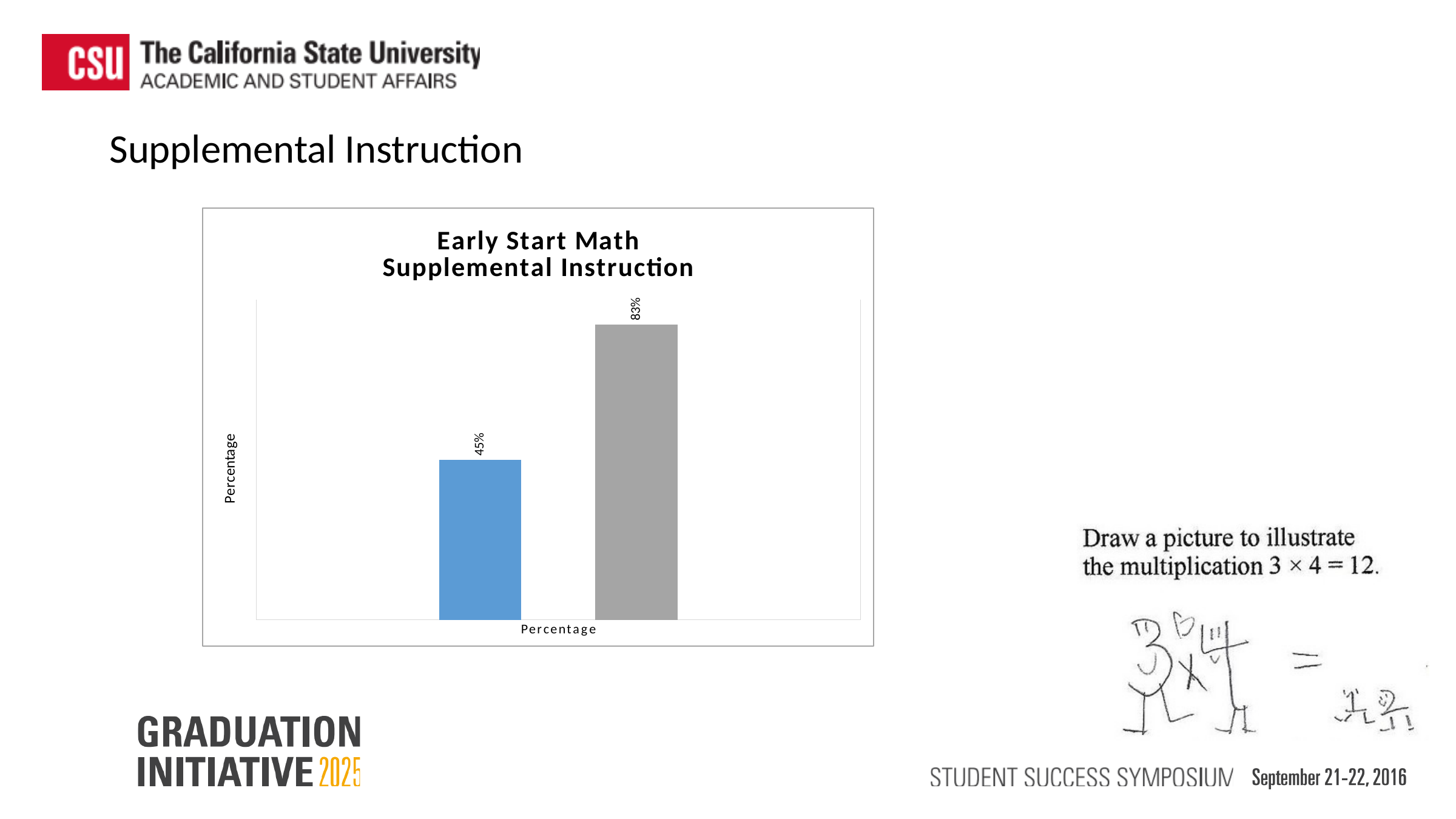
What is the label on the vertical axis of the Early Start Math Supplemental Instruction chart? Percentage Which bar is taller in the Early Start Math Supplemental Instruction chart, the blue one or the gray one? the gray one What kind of chart is the Early Start Math Supplemental Instruction chart? bar chart What value is shown on the blue bar in the Early Start Math Supplemental Instruction chart? 45% Is the value of the left bar larger or smaller than the value of the right bar in the Early Start Math Supplemental Instruction chart? smaller What is the difference between the gray bar and the blue bar in the Early Start Math Supplemental Instruction chart? 38% Which bar has the lowest value in the Early Start Math Supplemental Instruction chart? the blue bar What value is shown on the gray bar in the Early Start Math Supplemental Instruction chart? 83% What is the title of the chart on the slide? Early Start Math Supplemental Instruction How many bars are plotted in the Early Start Math Supplemental Instruction chart? 2